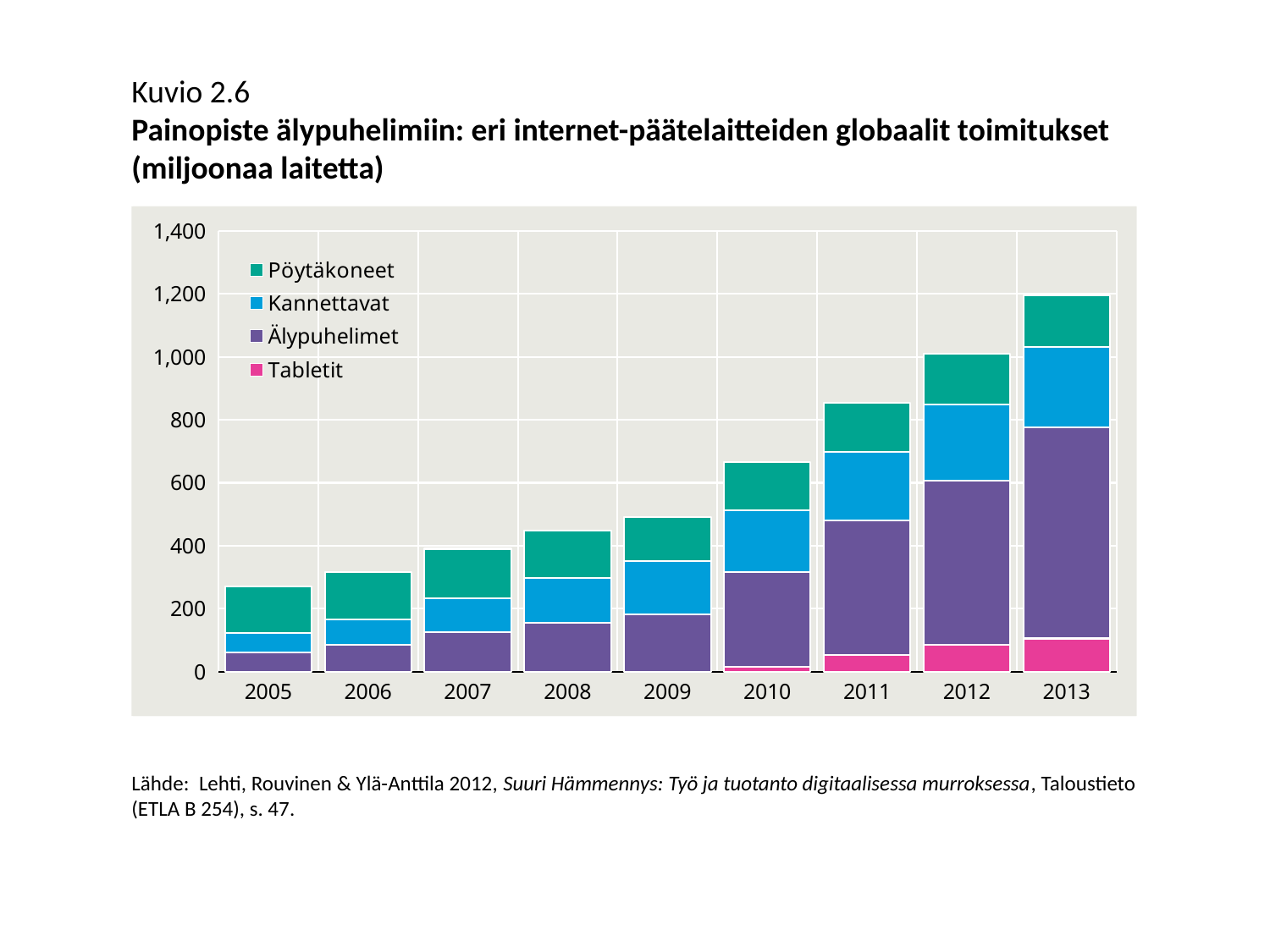
Which year has the lowest total shipments in the chart? 2005 Is the total value for 2005 greater or less than 200? greater Do the total shipments rise or fall from 2005 to 2013? Rise Is the total value for 2013 greater or less than 1,000? greater Is the total value for 2010 greater or less than 800? less What kind of chart is shown on the slide? Stacked bar chart How many series does the chart's legend list? 4 Which series is shown at the bottom of each stacked bar? Tabletit Which year has the highest total shipments in the chart? 2013 Which year has the larger total shipments, 2012 or 2013? 2013 What unit is given in the chart title for the shipments? miljoonaa laitetta How many years are shown on the x axis of the chart? 9